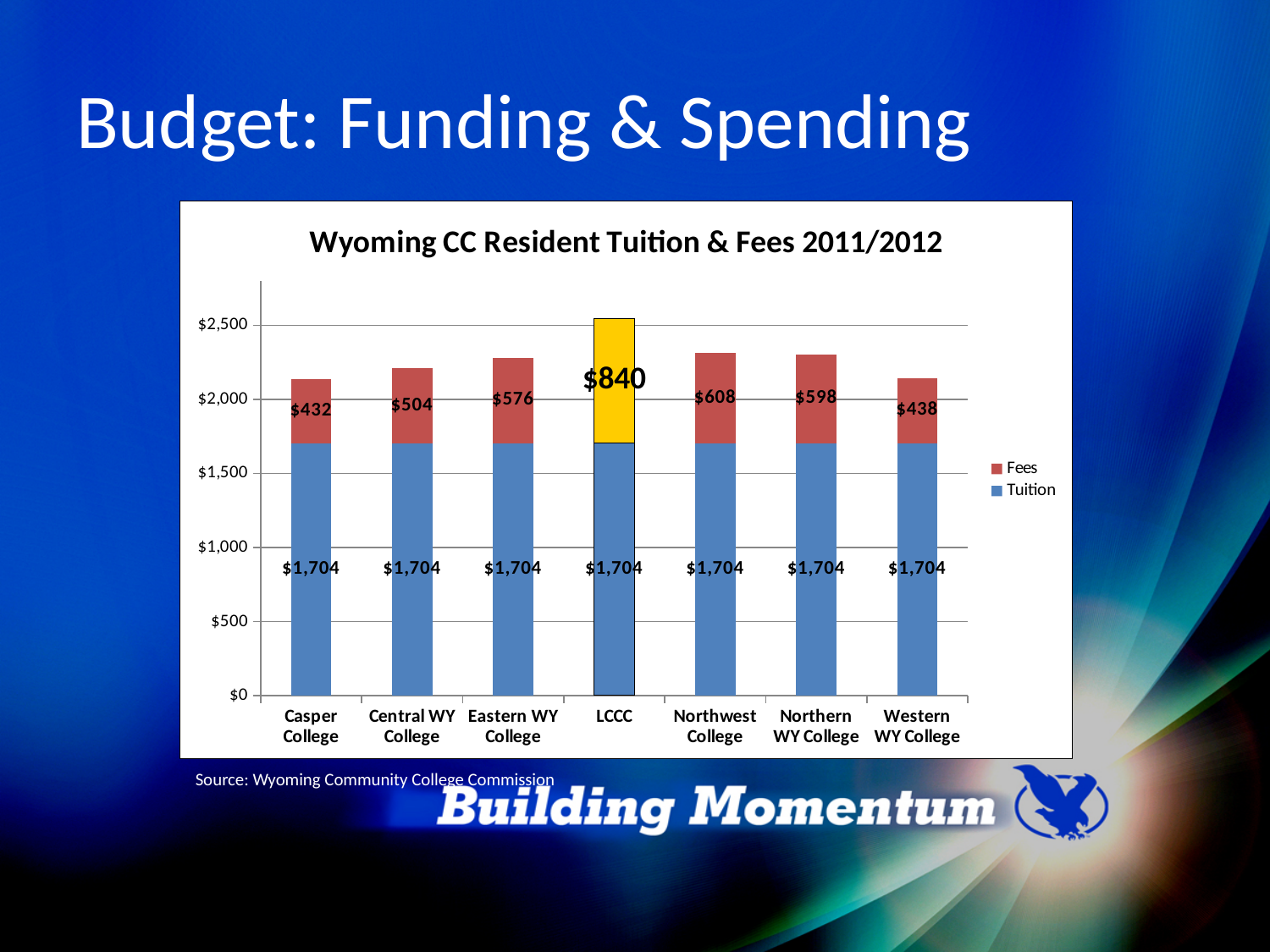
What is the difference between the Fees for LCCC and the Fees for Northwest College? $232 Which college has the highest Fees? LCCC How many colleges are shown on the x axis? 7 What is the Tuition value for Northwest College? $1,704 Which college has the lowest Fees? Casper College What is the Fees value for Eastern WY College? $576 What is the total of Tuition and Fees for LCCC? $2,544 What is the title of the chart? Wyoming CC Resident Tuition & Fees 2011/2012 How many series does the legend list? 2 Which is larger, the Fees for Central WY College or the Fees for Western WY College? Central WY College What is the Fees value for LCCC? $840 What type of chart is shown on the slide? Stacked bar chart